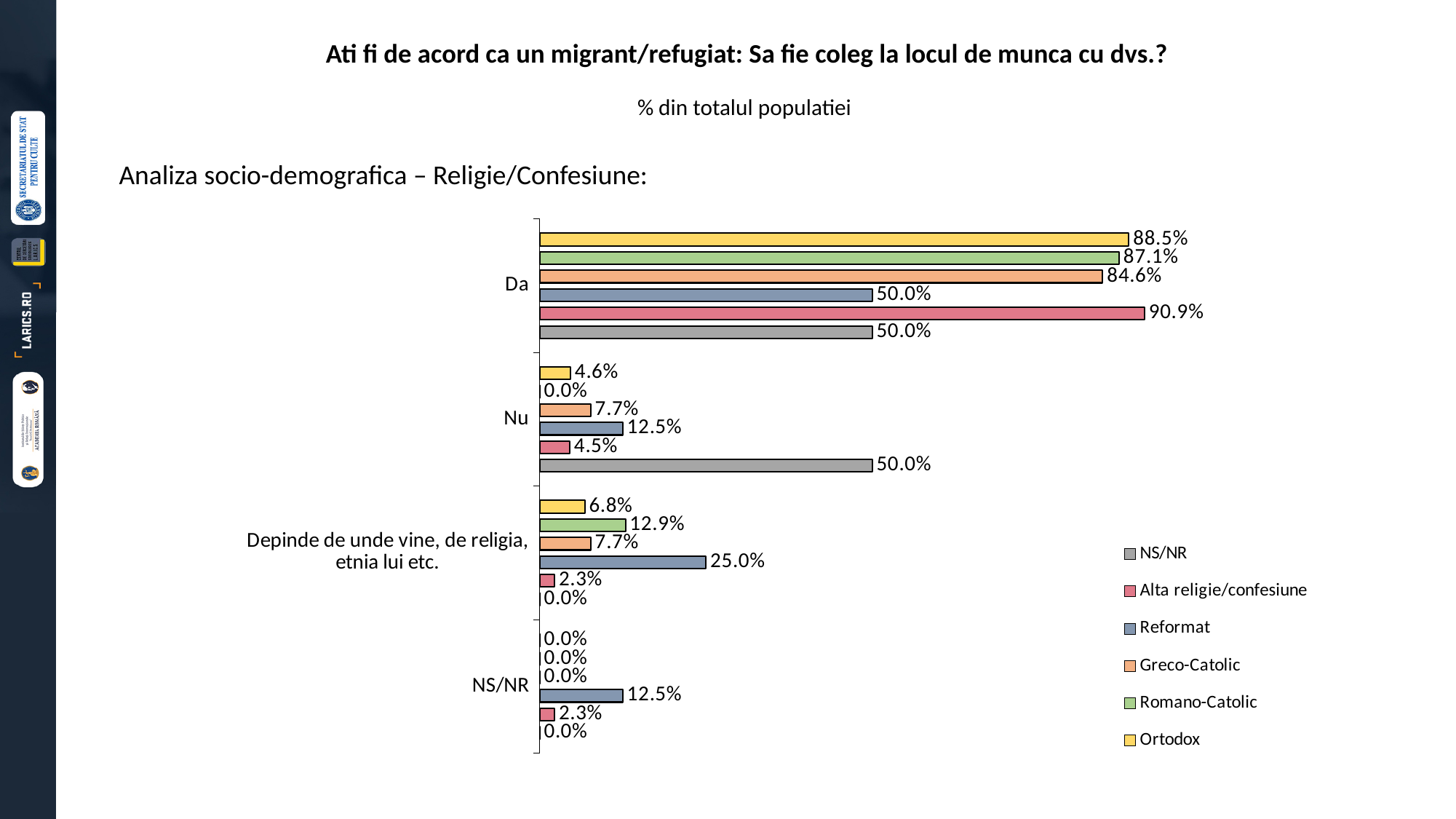
In the "Depinde de unde vine, de religia, etnia lui etc." category, which is larger: Romano-Catolic or Ortodox? Romano-Catolic What kind of chart is shown on the slide? Bar chart Which colour represents the Ortodox series in the legend? Yellow Which series has the highest value in the "Nu" category? NS/NR What is the value for Reformat in the "NS/NR" category? 12.5% What is the value for Greco-Catolic in the "Nu" category? 7.7% How many series does the legend list? 6 What percentage of Ortodox respondents answered "Da"? 88.5% What is the difference between the Ortodox and Romano-Catolic values in the "Da" category? 1.4% Which series has the highest value in the "Da" category? Alta religie/confesiune How many answer categories are shown on the vertical axis? 4 What is the value for Reformat in the "Depinde de unde vine, de religia, etnia lui etc." category? 25.0%